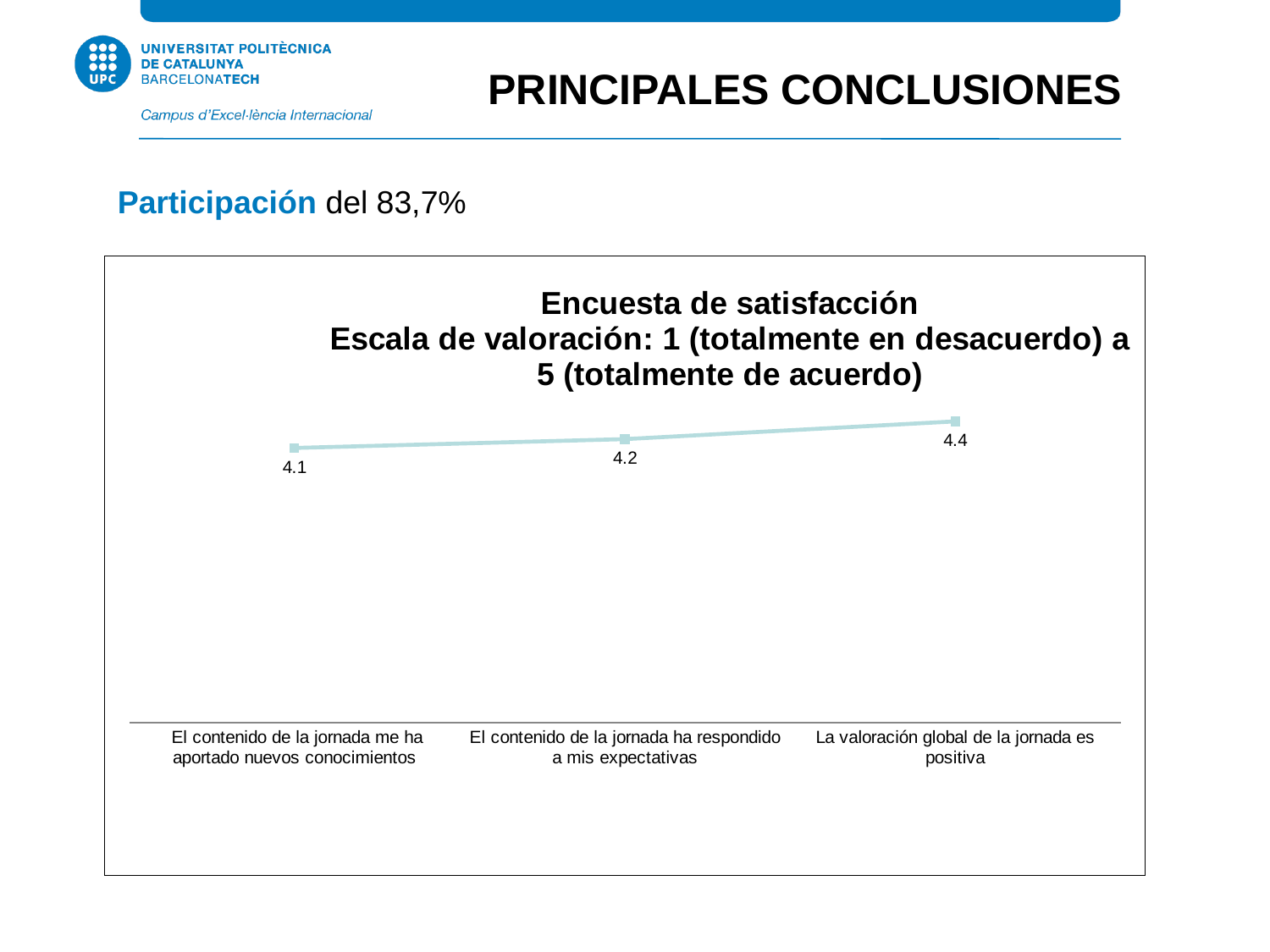
What is the difference between the value for "La valoración global de la jornada es positiva" and the value for "El contenido de la jornada ha respondido a mis expectativas"? 0.2 What is the value for "El contenido de la jornada ha respondido a mis expectativas"? 4.2 What is the difference between the value for "La valoración global de la jornada es positiva" and the value for "El contenido de la jornada me ha aportado nuevos conocimientos"? 0.3 Which category has the lowest value? El contenido de la jornada me ha aportado nuevos conocimientos What rating scale does the chart title say is used? 1 (totalmente en desacuerdo) a 5 (totalmente de acuerdo) Which category has the highest value? La valoración global de la jornada es positiva What is the value for "La valoración global de la jornada es positiva"? 4.4 How many categories are plotted on the chart? 3 Do the values rise or fall from left to right along the x axis? Rise What kind of chart is shown on the slide? Line chart What is the value for "El contenido de la jornada me ha aportado nuevos conocimientos"? 4.1 Which is larger: the value for "El contenido de la jornada ha respondido a mis expectativas" or the value for "El contenido de la jornada me ha aportado nuevos conocimientos"? El contenido de la jornada ha respondido a mis expectativas